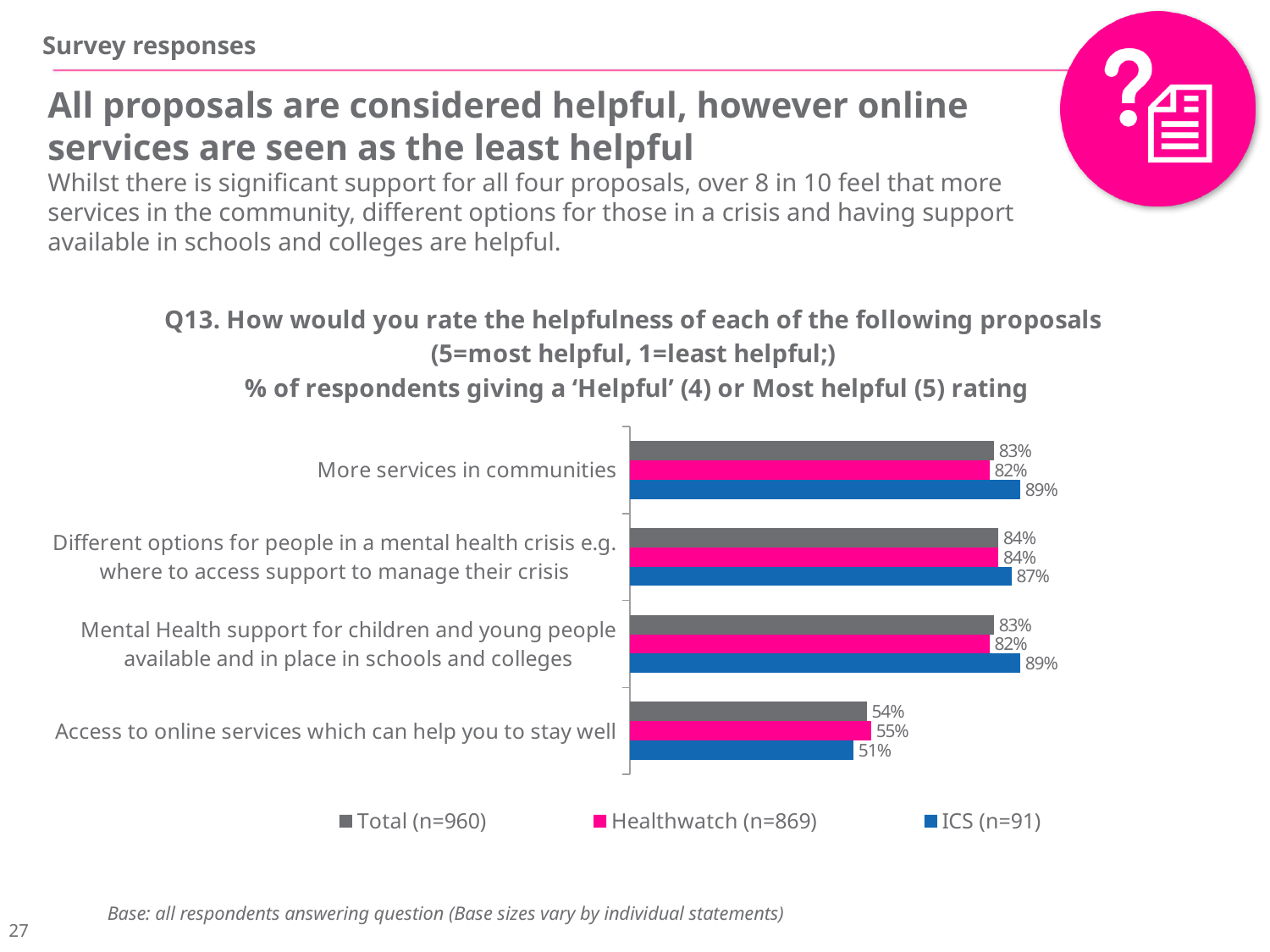
What is the ICS value for 'Access to online services which can help you to stay well'? 51% Which proposal has the highest Healthwatch value? Different options for people in a mental health crisis e.g. where to access support to manage their crisis For 'Access to online services which can help you to stay well', which is larger: the Healthwatch value or the ICS value? Healthwatch Which proposal has the lowest Total value? Access to online services which can help you to stay well What percentage of Total respondents rated 'More services in communities' as helpful or most helpful? 83% What kind of chart is shown on the slide? Bar chart Which colour represents the ICS series in the chart? Blue How many proposals are shown in the chart? 4 What is the difference between the ICS and Total values for 'More services in communities'? 6 percentage points What is the sample size for the Healthwatch series shown in the legend? 869 How many series does the legend list? 3 What is the Healthwatch value for 'Different options for people in a mental health crisis e.g. where to access support to manage their crisis'? 84%